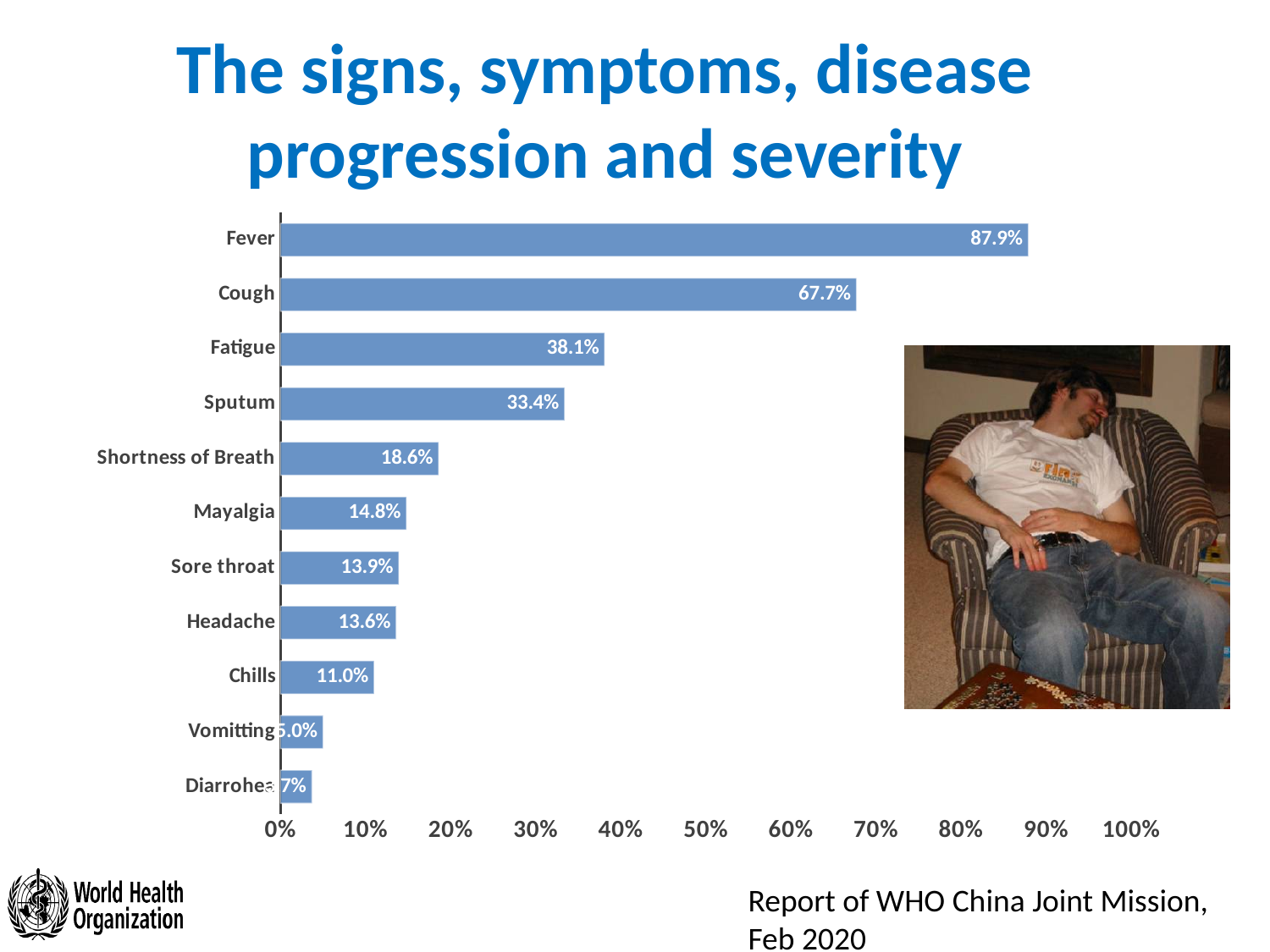
Which symptom has the lowest value? Diarrohea What kind of chart is shown on the slide? Bar chart Is the value for Diarrohea greater or less than 10%? less What is the difference between the values for Fever and Cough? 20.2% What is the value for Headache? 13.6% What is the value for Cough? 67.7% How many symptoms are shown in the chart? 11 Which is larger, the value for Sputum or the value for Shortness of Breath? Sputum Which symptom has the highest value? Fever What is the value for Shortness of Breath? 18.6% What is the value for Fever? 87.9% What is the difference between the values for Fatigue and Sputum? 4.7%